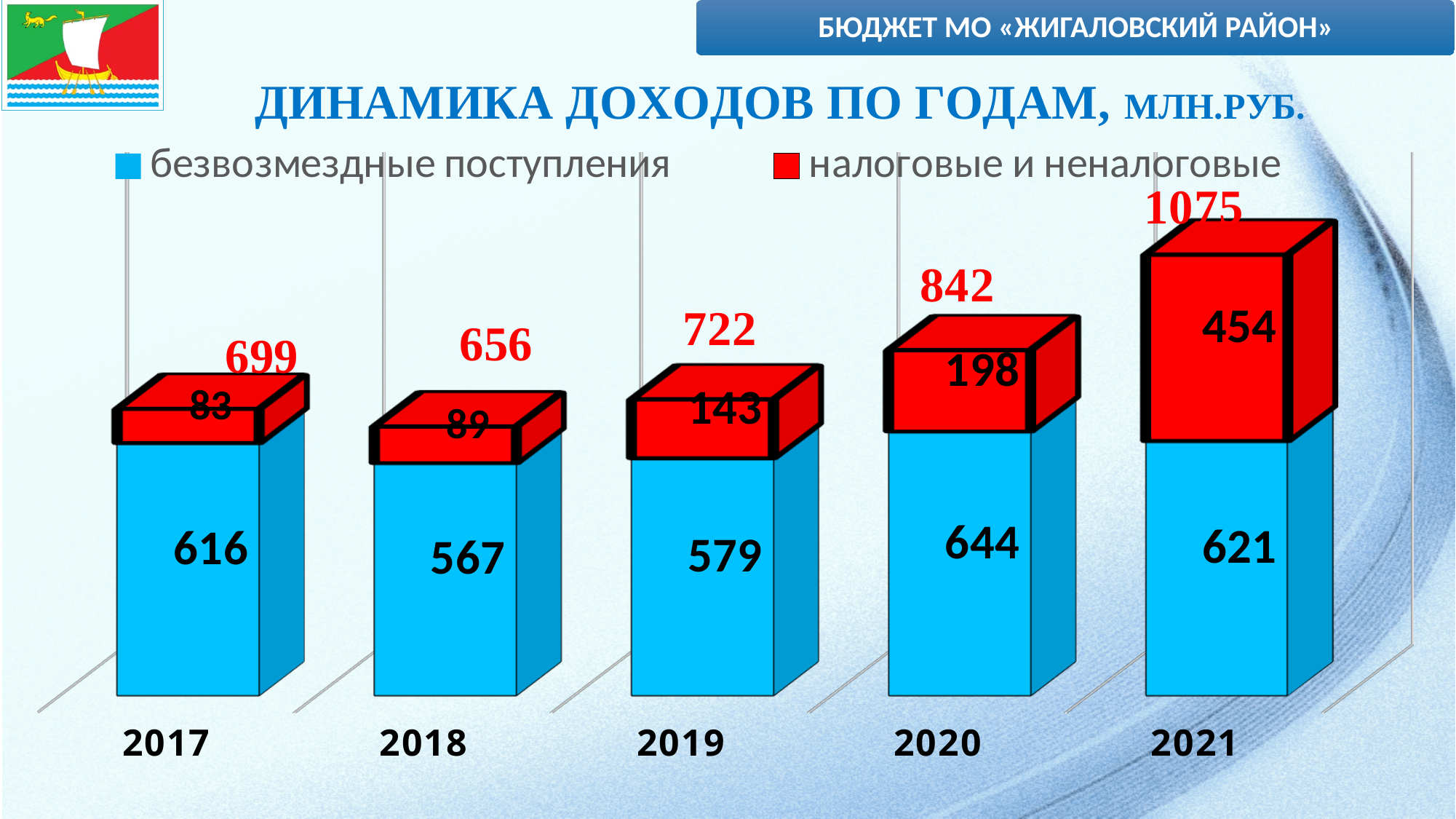
Which colour represents «налоговые и неналоговые» in the legend? red How many series does the legend list? 2 Which year has the highest total income? 2021 What is the value of «безвозмездные поступления» for 2017? 616 What kind of chart is shown on the slide? stacked bar chart What is the difference between the total for 2021 and the total for 2020? 233 Do the values for «налоговые и неналоговые» rise or fall from 2017 to 2021? rise Which is larger: «безвозмездные поступления» in 2018 or in 2019? 2019 How many years are shown on the x axis? 5 Which year has the lowest value for «налоговые и неналоговые»? 2017 What is the total income shown above the bar for 2020? 842 What is the value of «налоговые и неналоговые» for 2021? 454